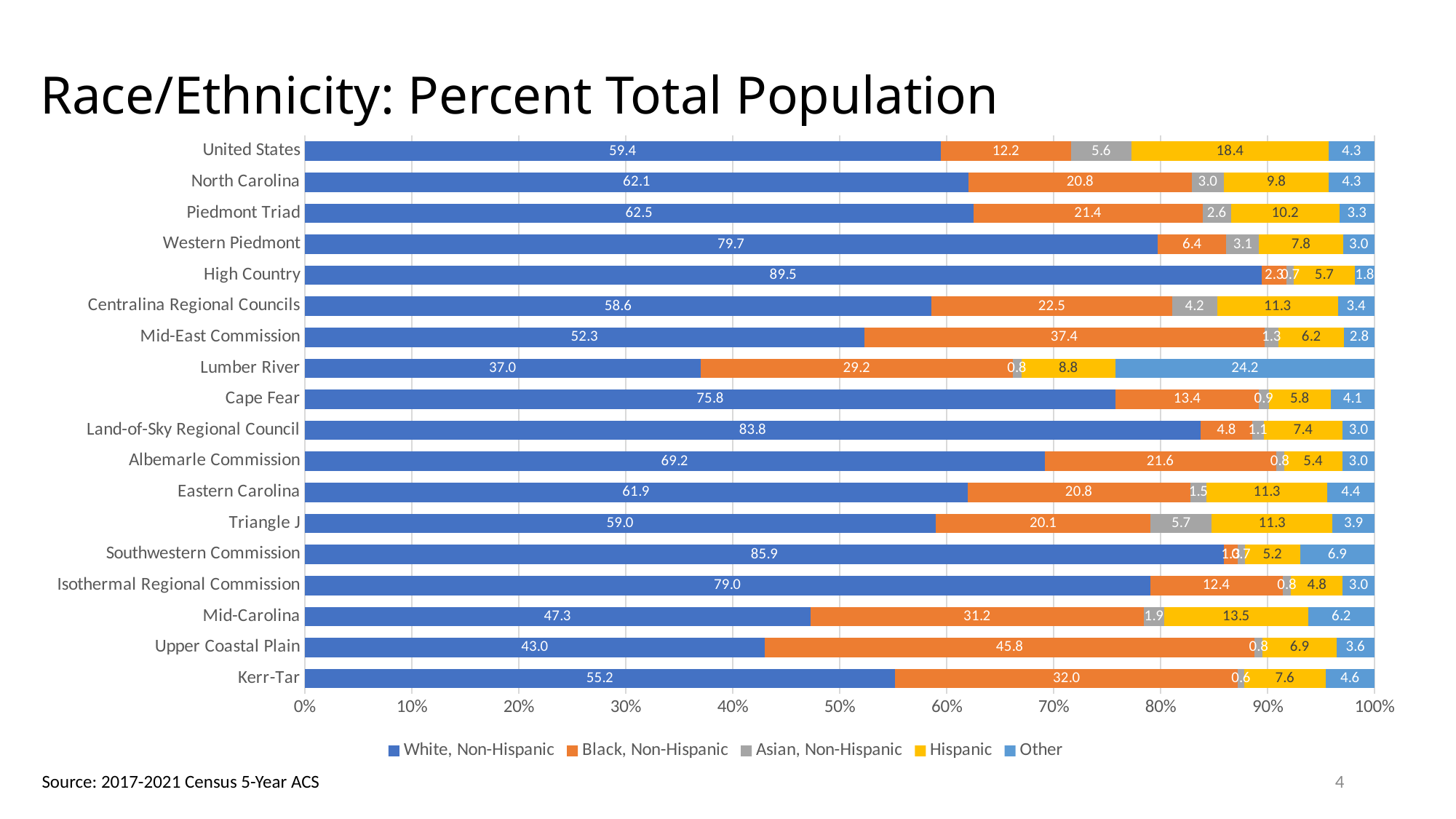
What is the Black, Non-Hispanic percentage for Upper Coastal Plain? 45.8 Which region has the highest White, Non-Hispanic percentage? High Country What is the difference between the Black, Non-Hispanic percentages for Mid-East Commission and North Carolina? 16.6 What is the Hispanic percentage for Mid-Carolina? 13.5 What type of chart is shown on the slide? Stacked bar chart Which region has the lowest White, Non-Hispanic percentage? Lumber River How many regions are listed on the chart? 18 What is the Other percentage for Lumber River? 24.2 How many series does the legend list? 5 What is the White, Non-Hispanic percentage for the United States? 59.4 Is the White, Non-Hispanic value for Western Piedmont greater or less than 70%? greater Which has a larger Hispanic percentage, the United States or North Carolina? United States